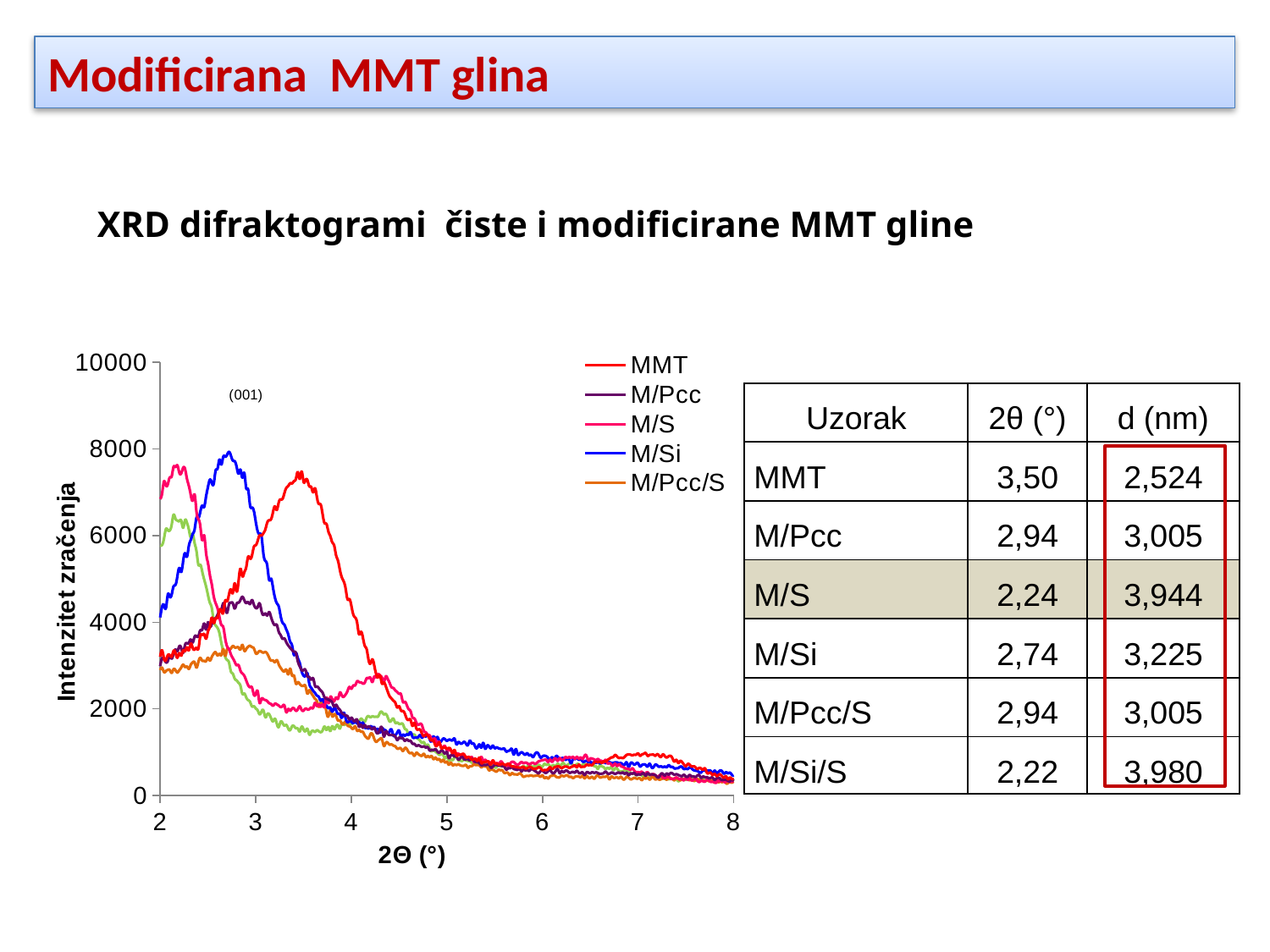
Is the peak intensity of the M/Pcc series greater or less than 6000? less Which series listed in the legend reaches the lowest peak intensity? M/Pcc/S Is the peak intensity of the M/Si series greater or less than 6000? greater Does the intensity of the MMT series rise or fall as 2Θ increases from 4 to 8? fall What kind of chart is shown on the slide? line chart Is the peak intensity of the M/Pcc/S series greater or less than 4000? less What is the label of the y axis of the chart? Intenzitet zračenja How many series does the chart legend list? 5 What is the label of the x axis of the chart? 2Θ (°) What is the lowest value shown on the x axis of the chart? 2 At 2Θ = 3.5°, which series has the higher intensity, MMT or M/Pcc/S? MMT